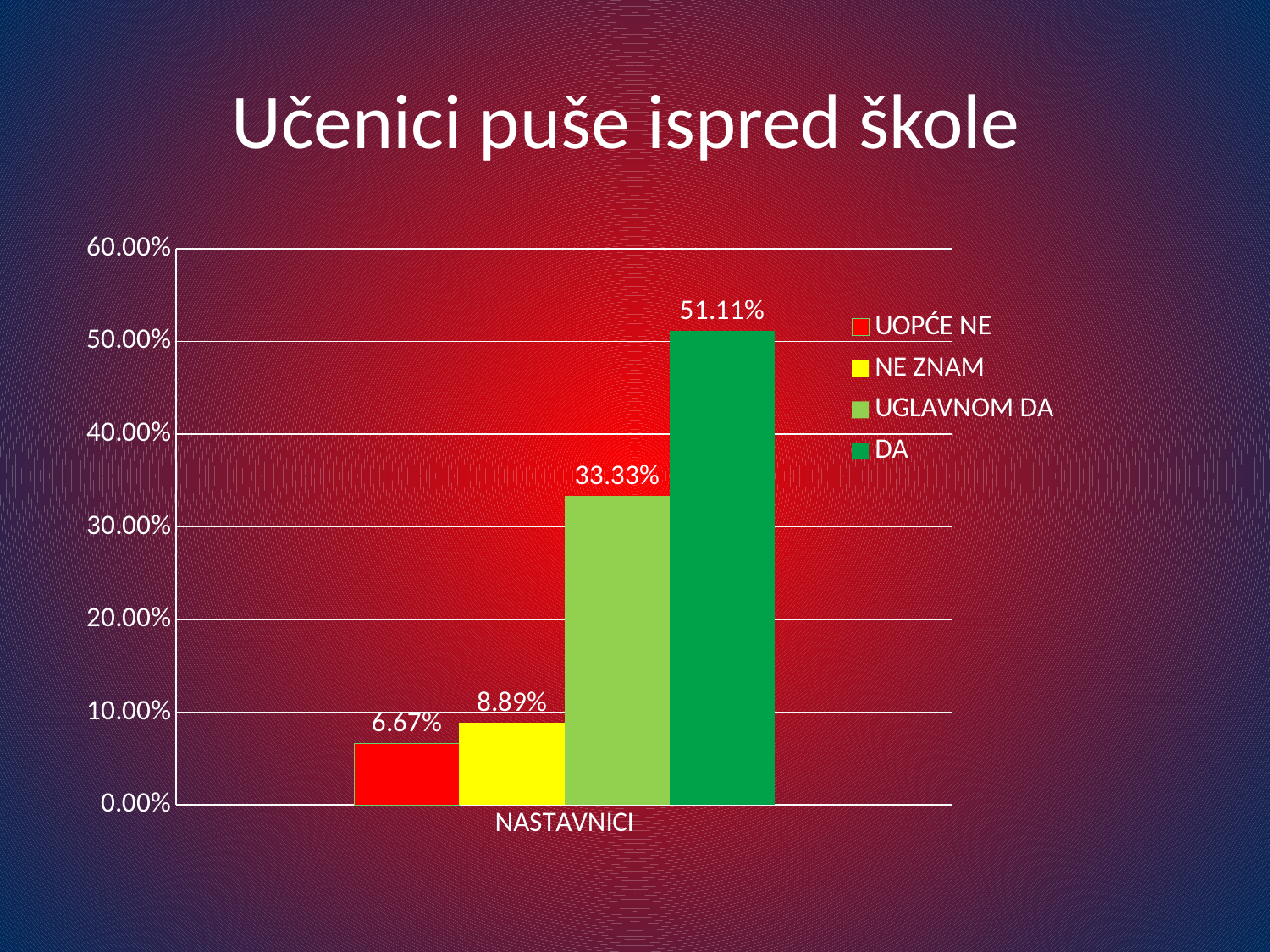
What is the title of the slide? Učenici puše ispred škole What is the difference between the values for DA and UGLAVNOM DA? 17.78% What is the value for DA? 51.11% Which is larger, the value for NE ZNAM or the value for UOPĆE NE? NE ZNAM What is the value for UOPĆE NE? 6.67% What is the value for NE ZNAM? 8.89% What is the value for UGLAVNOM DA? 33.33% How many series does the legend list? 4 What kind of chart is shown on the slide? bar chart Which series has the highest value? DA Is the value for DA greater or less than 50.00%? greater Which series has the lowest value? UOPĆE NE